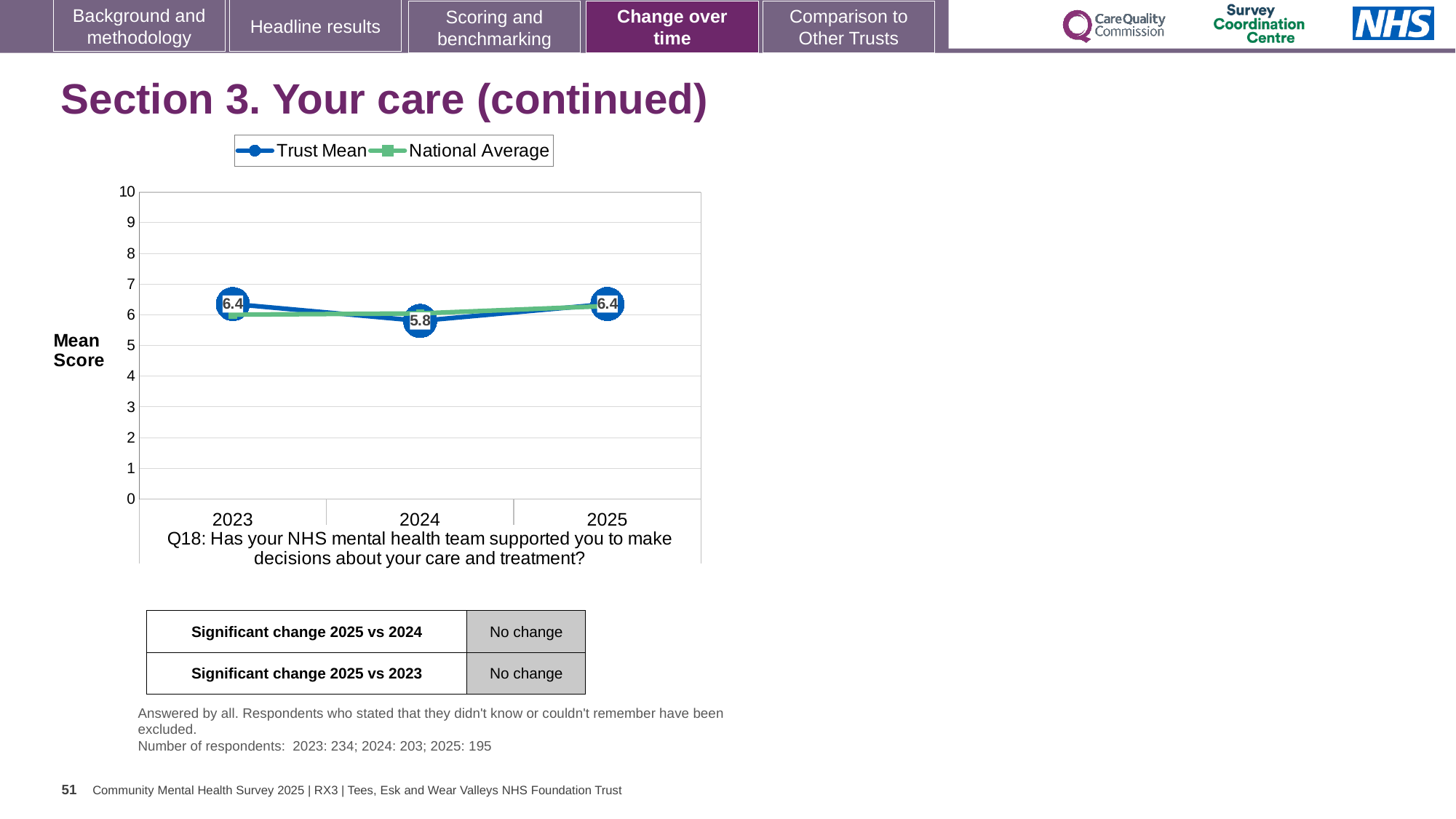
Which series is shown in green in the chart legend? National Average Is the Trust Mean value for 2024 greater or less than 5? greater What kind of chart is shown on the slide? Line chart Which is larger, the Trust Mean score for 2024 or for 2025? 2025 In which year is the Trust Mean score lowest? 2024 Is the National Average value for 2025 greater or less than 7? less How many series does the chart legend list? 2 What is the Trust Mean score for 2025? 6.4 What is the Trust Mean score for 2024? 5.8 How many years are shown on the x axis of the chart? 3 What is the difference between the Trust Mean scores for 2023 and 2024? 0.6 What is the Trust Mean score for 2023? 6.4